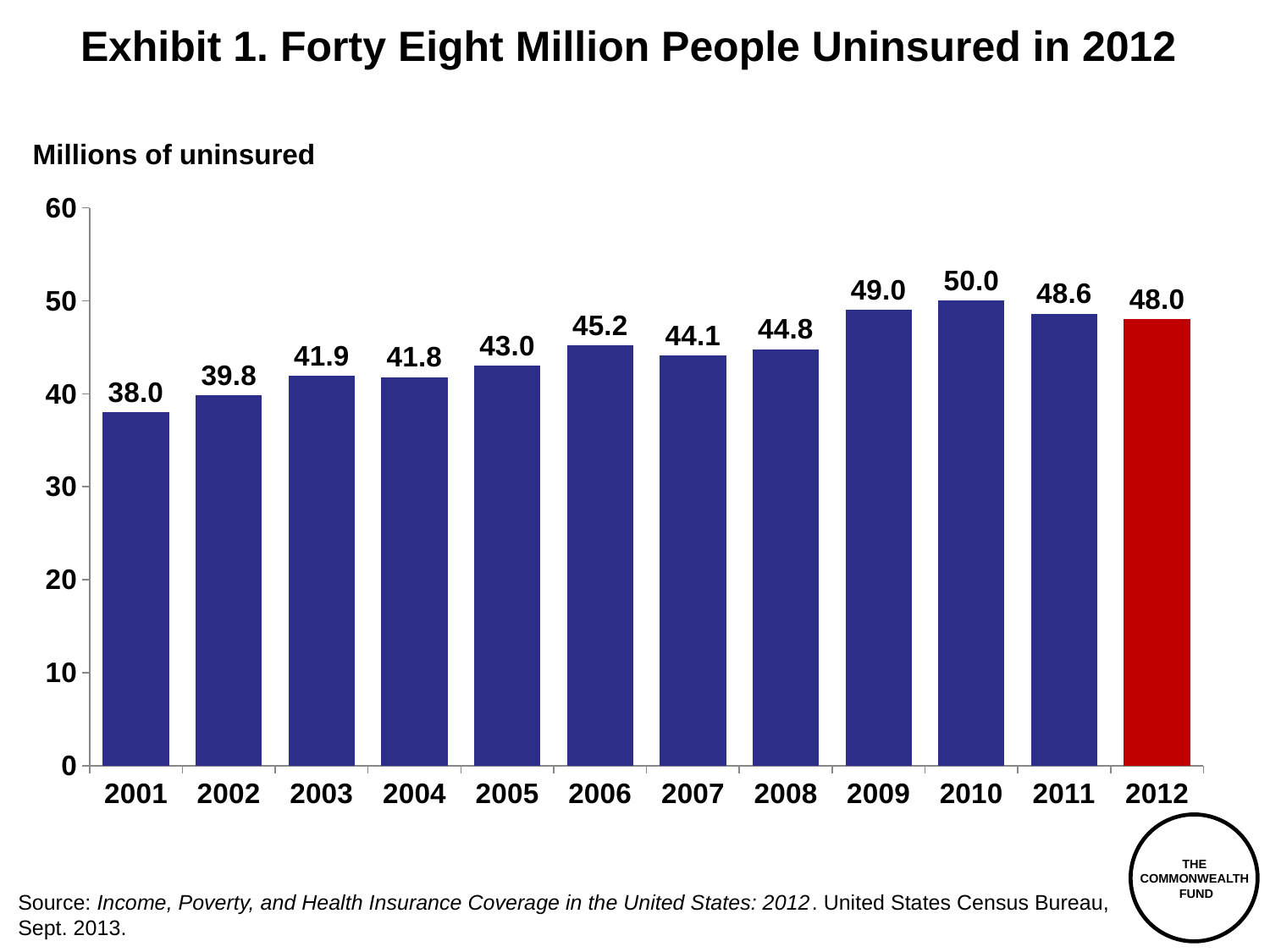
Is the value for 2009 greater or less than 40? greater What is the value for 2012? 48.0 What kind of chart is this? bar chart What is the value for 2007? 44.1 Which year has the highest value? 2010 What is the difference between the values for 2010 and 2012? 2.0 Which year has the lowest value? 2001 What is the difference between the values for 2012 and 2001? 10.0 Which bar is shown in a different colour (red) from the others? 2012 How many years are shown on the x axis? 12 What is the value for 2001? 38.0 Which is larger, the value for 2006 or the value for 2007? 2006